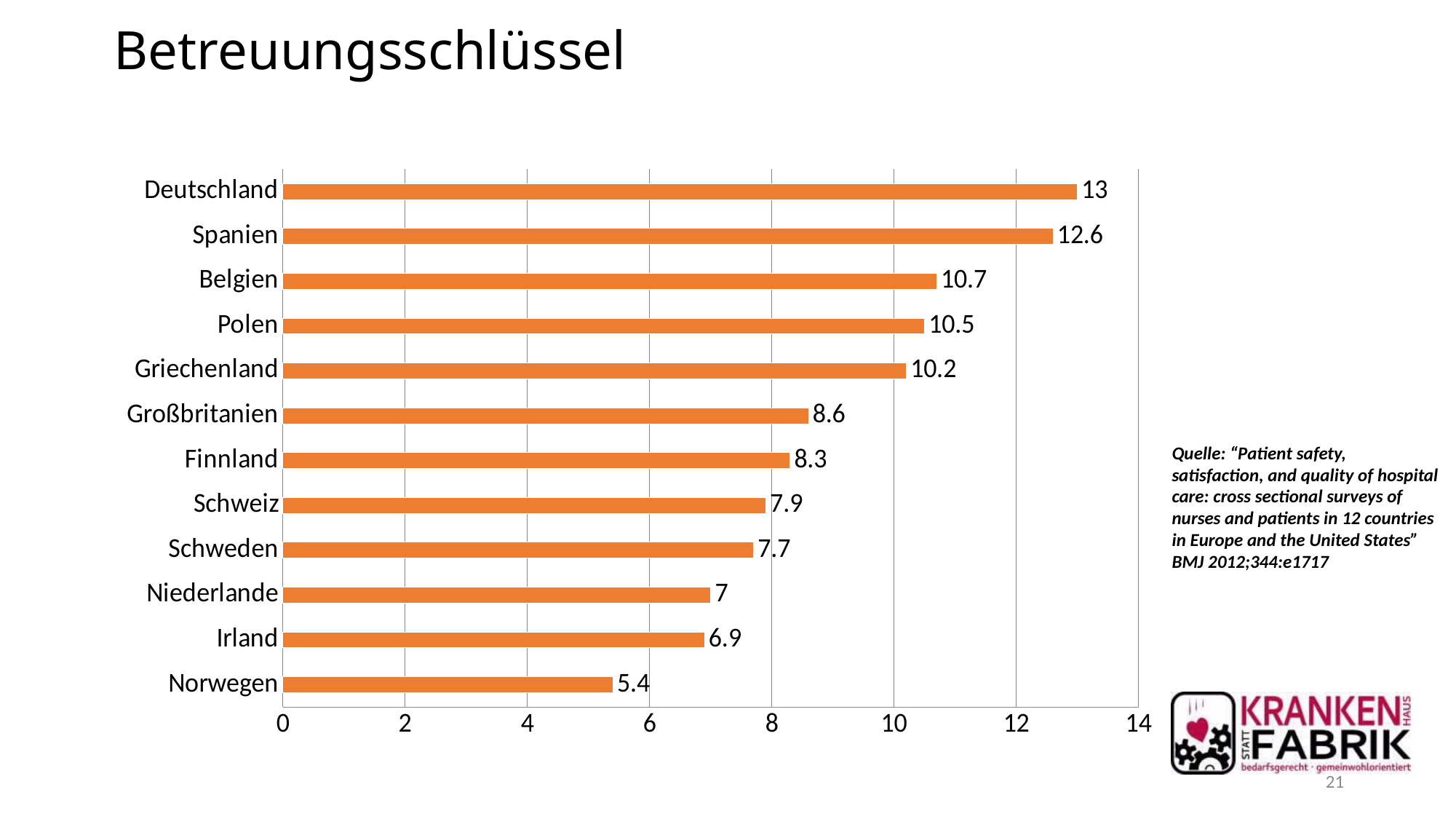
What kind of chart is shown on the slide? Bar chart Which country has the highest value? Deutschland Is the value for Polen greater or less than 10? greater How many countries are shown in the chart? 12 What is the difference between the values for Deutschland and Norwegen? 7.6 What is the difference between the values for Spanien and Belgien? 1.9 Which country has the lowest value? Norwegen What is the value for Griechenland? 10.2 What is the value for Deutschland? 13 What is the title of the slide? Betreuungsschlüssel What is the value for Schweden? 7.7 Which has a larger value, Finnland or Großbritanien? Großbritanien